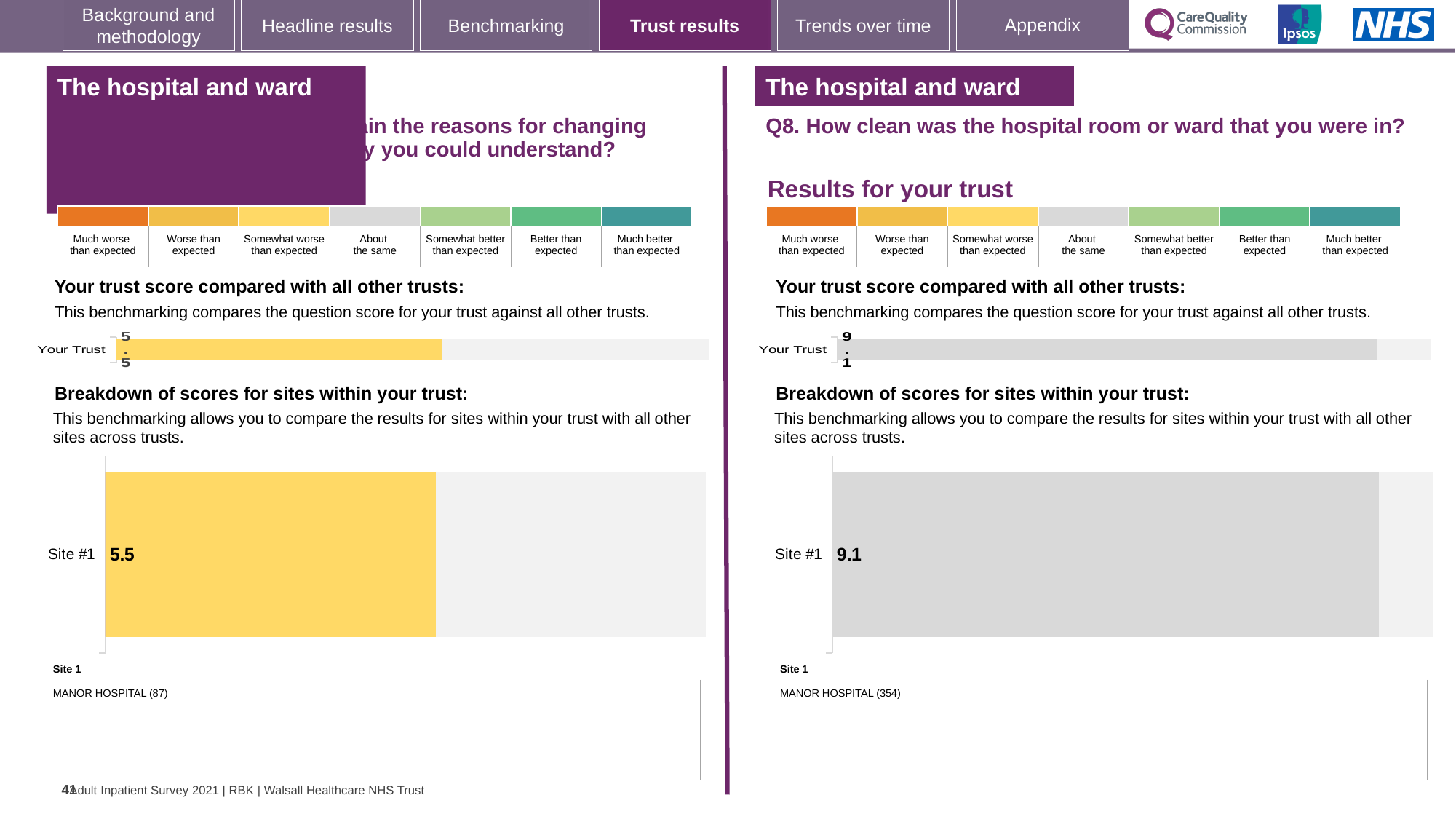
What kind of chart is used to show the Site #1 score on the right-hand panel (Q8)? Bar chart According to the colour key, which rating category does the colour of the Site #1 bar on the left-hand chart correspond to? Somewhat worse than expected On the right-hand panel (Q8), how many respondents are shown in brackets for Site 1, MANOR HOSPITAL? 354 On the right-hand chart (Q8. How clean was the hospital room or ward that you were in?), what is the score shown for Your Trust? 9.1 On the left-hand chart, what is the score shown for Your Trust? 5.5 How many sites are shown in the breakdown of scores for sites within your trust on the right-hand chart (Q8)? 1 Is the Your Trust score on the left-hand chart greater or less than the Your Trust score on the right-hand chart (Q8)? less Which is larger: the Site #1 score on the left-hand chart or the Site #1 score on the right-hand chart (Q8)? The right-hand chart (Q8) What is the difference between the Your Trust score on the right-hand chart (Q8) and the Your Trust score on the left-hand chart? 3.6 On the right-hand chart (Q8), what score is shown for Site #1 in the breakdown of scores for sites within your trust? 9.1 How many rating categories are shown in the colour key above the left-hand chart? 7 On the left-hand chart, what score is shown for Site #1 in the breakdown of scores for sites within your trust? 5.5